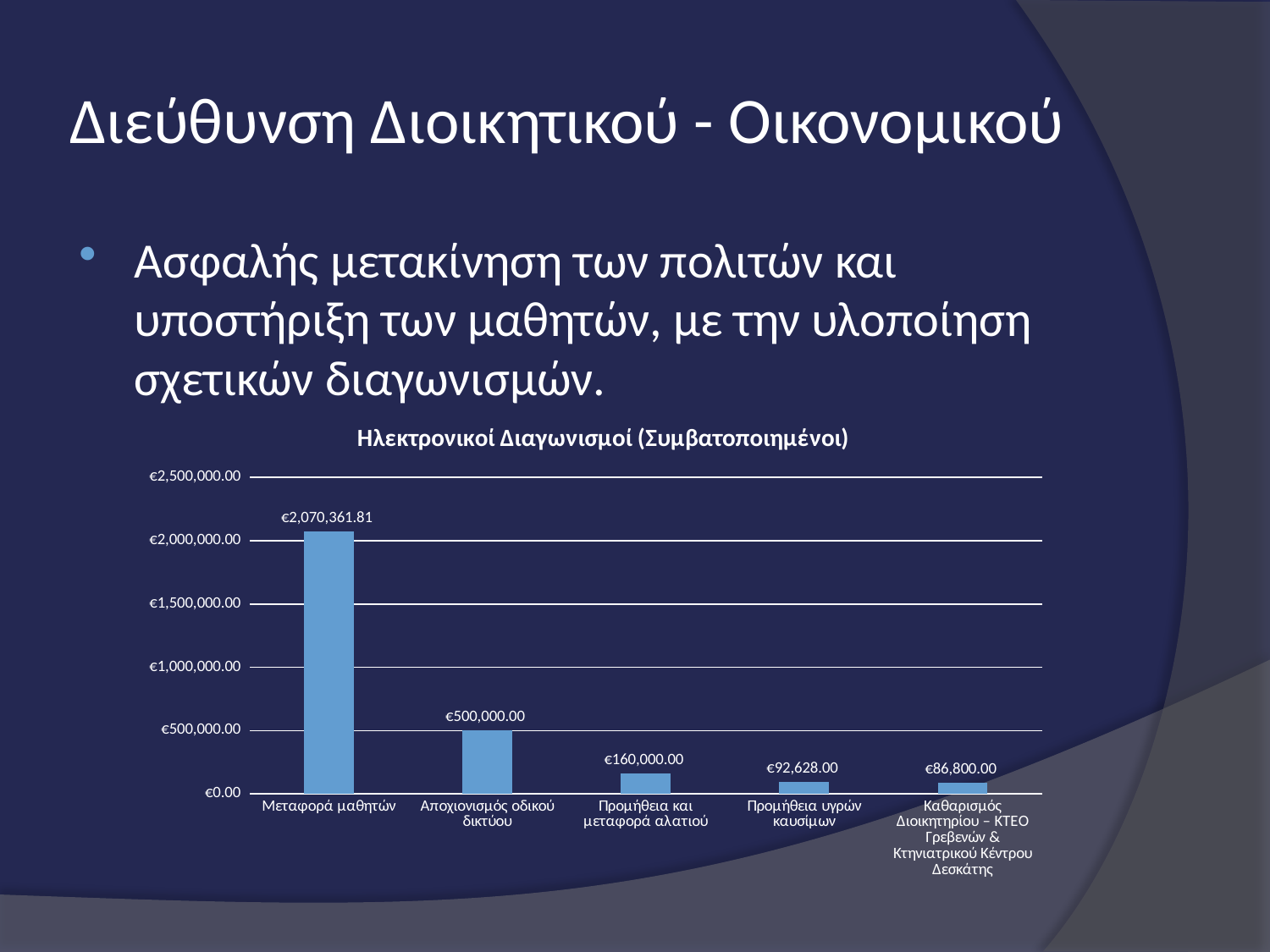
What is the value for Προμήθεια υγρών καυσίμων? €92,628.00 What is the value for Καθαρισμός Διοικητηρίου – ΚΤΕΟ Γρεβενών & Κτηνιατρικού Κέντρου Δεσκάτης? €86,800.00 Which category has the lowest value? Καθαρισμός Διοικητηρίου – ΚΤΕΟ Γρεβενών & Κτηνιατρικού Κέντρου Δεσκάτης How many categories are shown in the chart? 5 What is the value for Αποχιονισμός οδικού δικτύου? €500,000.00 Which is larger, the value for Αποχιονισμός οδικού δικτύου or the value for Προμήθεια και μεταφορά αλατιού? Αποχιονισμός οδικού δικτύου What is the title of the chart? Ηλεκτρονικοί Διαγωνισμοί (Συμβατοποιημένοι) What is the difference between the values for Μεταφορά μαθητών and Αποχιονισμός οδικού δικτύου? €1,570,361.81 What is the value for Μεταφορά μαθητών? €2,070,361.81 Which category has the highest value? Μεταφορά μαθητών What is the difference between the values for Προμήθεια και μεταφορά αλατιού and Προμήθεια υγρών καυσίμων? €67,372.00 What kind of chart is shown on the slide? Bar chart